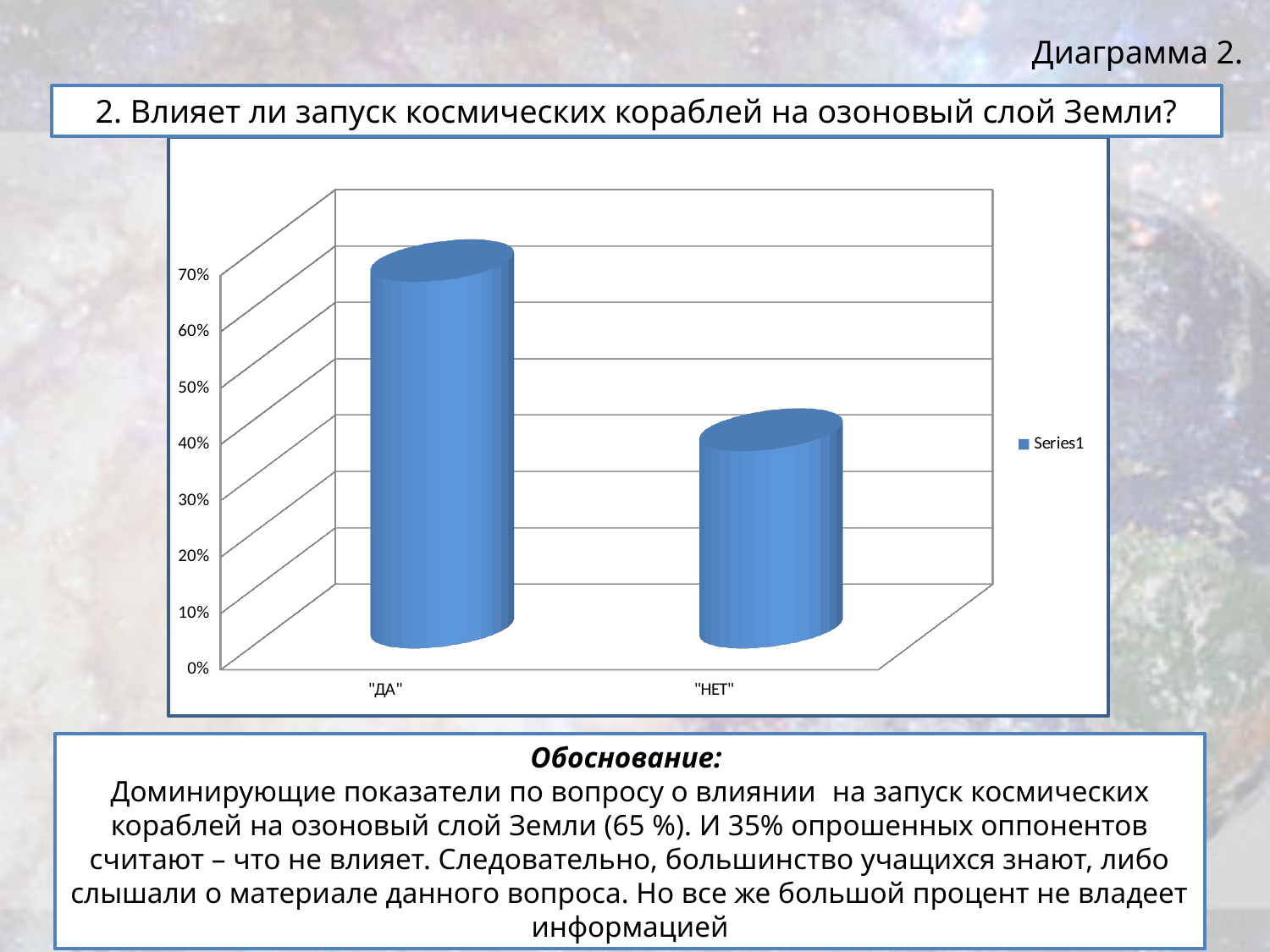
What kind of chart is shown on the slide? bar chart Which category has the highest bar? "ДА" Is the value for "НЕТ" greater or less than 20%? greater Do the bar values rise or fall from "ДА" to "НЕТ" along the x axis? fall Is the value for "ДА" greater or less than 50%? greater Which bar is taller, "ДА" or "НЕТ"? "ДА" What is the highest tick label shown on the vertical axis? 70% Which category has the lowest bar? "НЕТ" What is the name of the series shown in the legend? Series1 How many series does the chart legend list? 1 How many categories are shown on the x axis of the chart? 2 Is the value for "НЕТ" greater or less than 50%? less